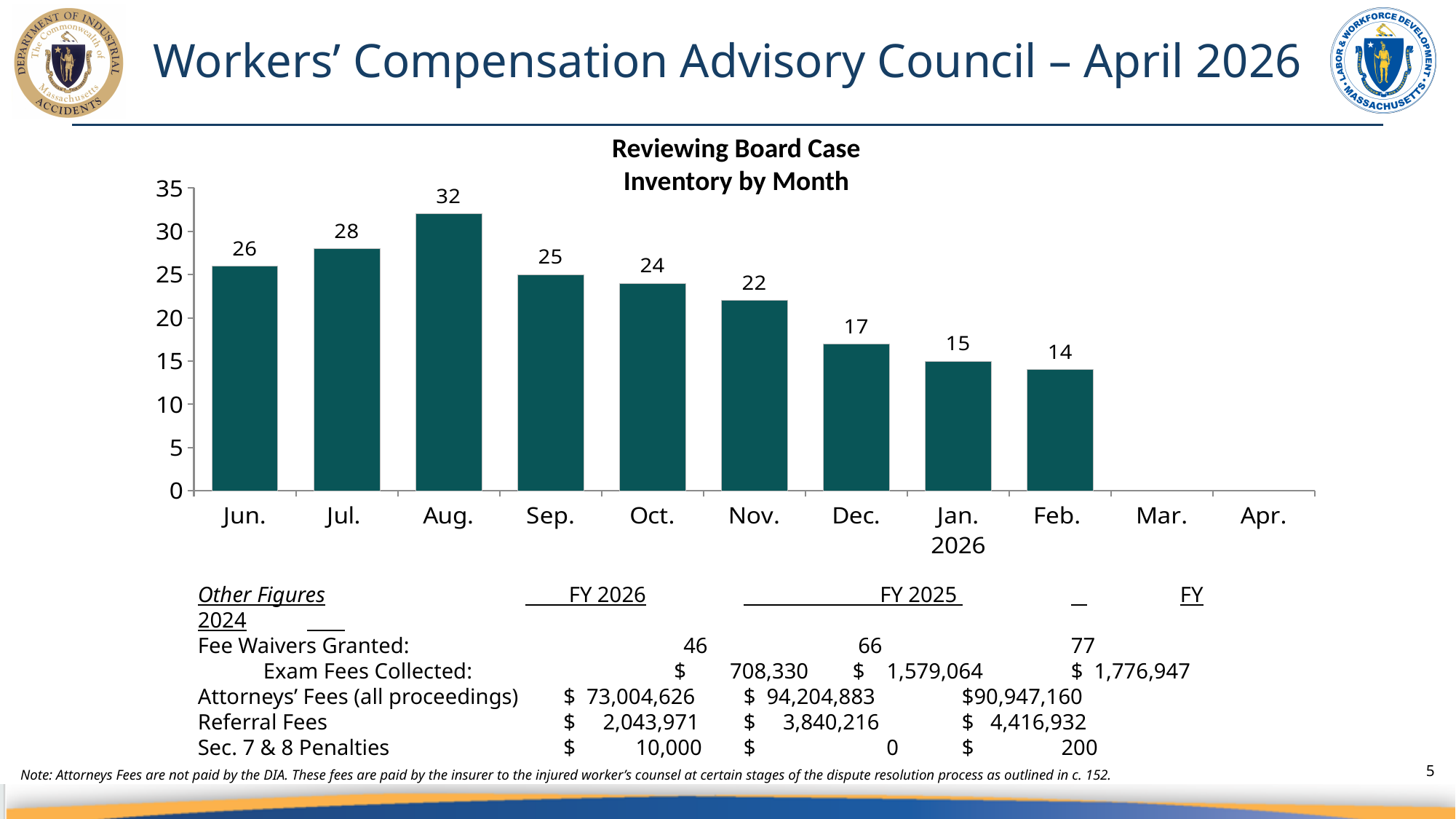
Is the case inventory for Oct. greater or less than 20? greater What is the Reviewing Board case inventory for Nov.? 22 What is the difference between the case inventory in Aug. and in Feb.? 18 What kind of chart is shown on the slide? Bar chart From Aug. to Feb., does the case inventory rise or fall? Fall What is the difference between the case inventory in Jun. and in Jul.? 2 What is the Reviewing Board case inventory for Aug.? 32 What is the Reviewing Board case inventory for Feb.? 14 How many months have a bar plotted in the chart? 9 Which month has the highest Reviewing Board case inventory? Aug. Which month with a plotted bar has the lowest Reviewing Board case inventory? Feb. Which month has a larger case inventory, Sep. or Dec.? Sep.